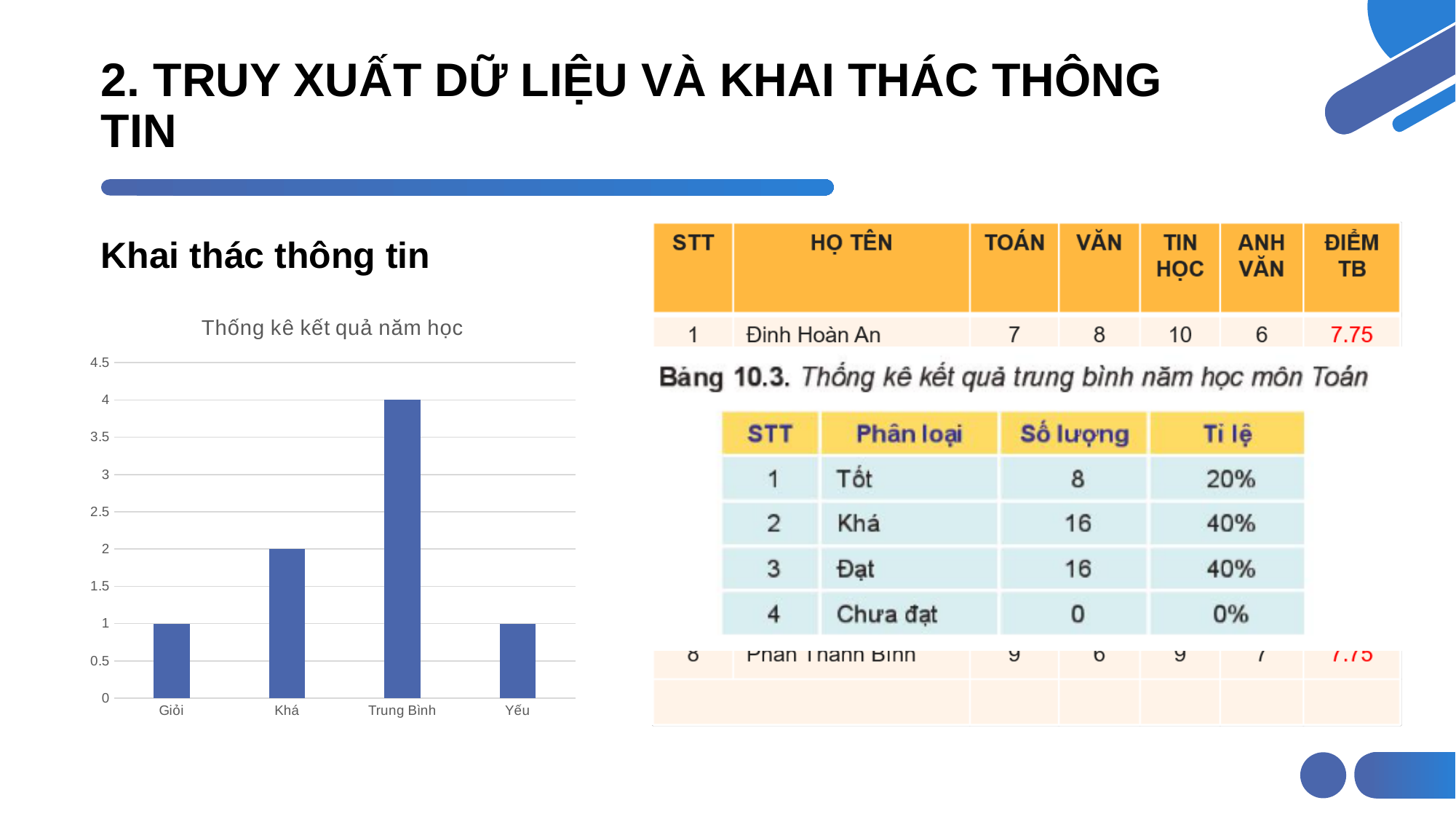
Is the value for Trung Bình greater or less than 3? greater How many categories are shown on the x axis of the chart? 4 What is the value for Khá in the chart? 2 What is the value for Yếu in the chart? 1 What is the value for Giỏi in the chart? 1 What is the difference between the values for Trung Bình and Khá? 2 Which category has the highest value in the chart? Trung Bình Which is larger, the value for Khá or the value for Giỏi? Khá What is the value for Trung Bình in the chart? 4 What is the highest value shown on the y axis of the chart? 4.5 What kind of chart is shown on the slide? bar chart What is the title of the chart on the slide? Thống kê kết quả năm học